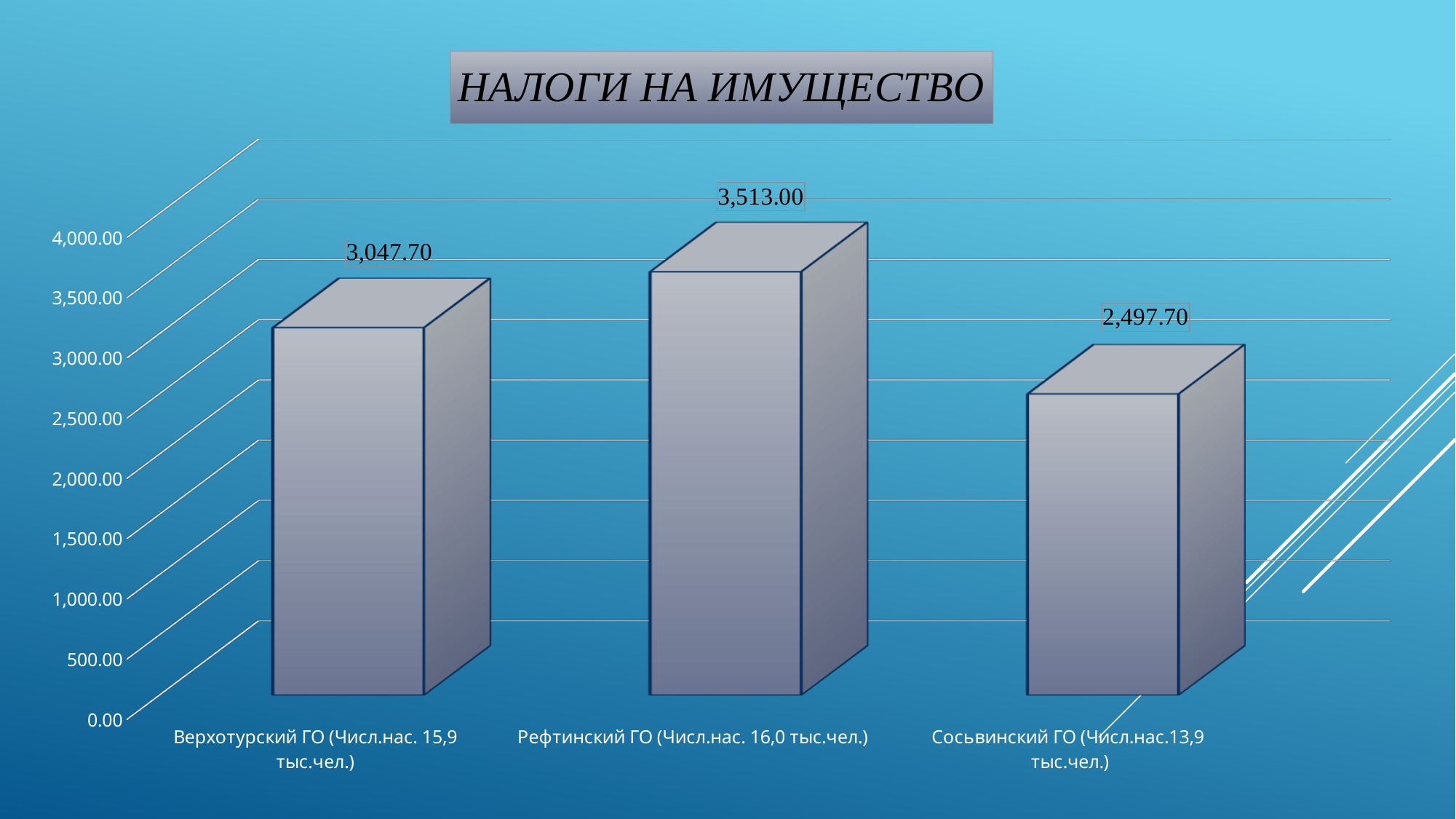
What is the title of the chart? НАЛОГИ НА ИМУЩЕСТВО Which category has the highest value? Рефтинский ГО Which category has the lowest value? Сосьвинский ГО What is the value for Верхотурский ГО? 3,047.70 What is the difference between the values for Рефтинский ГО and Верхотурский ГО? 465.30 Is the value for Сосьвинский ГО greater or less than 3,000.00? less What is the value for Сосьвинский ГО? 2,497.70 Which is larger, the value for Верхотурский ГО or the value for Сосьвинский ГО? Верхотурский ГО What is the difference between the values for Верхотурский ГО and Сосьвинский ГО? 550.00 How many categories are shown on the chart? 3 What is the value for Рефтинский ГО? 3,513.00 What kind of chart is shown on the slide? bar chart